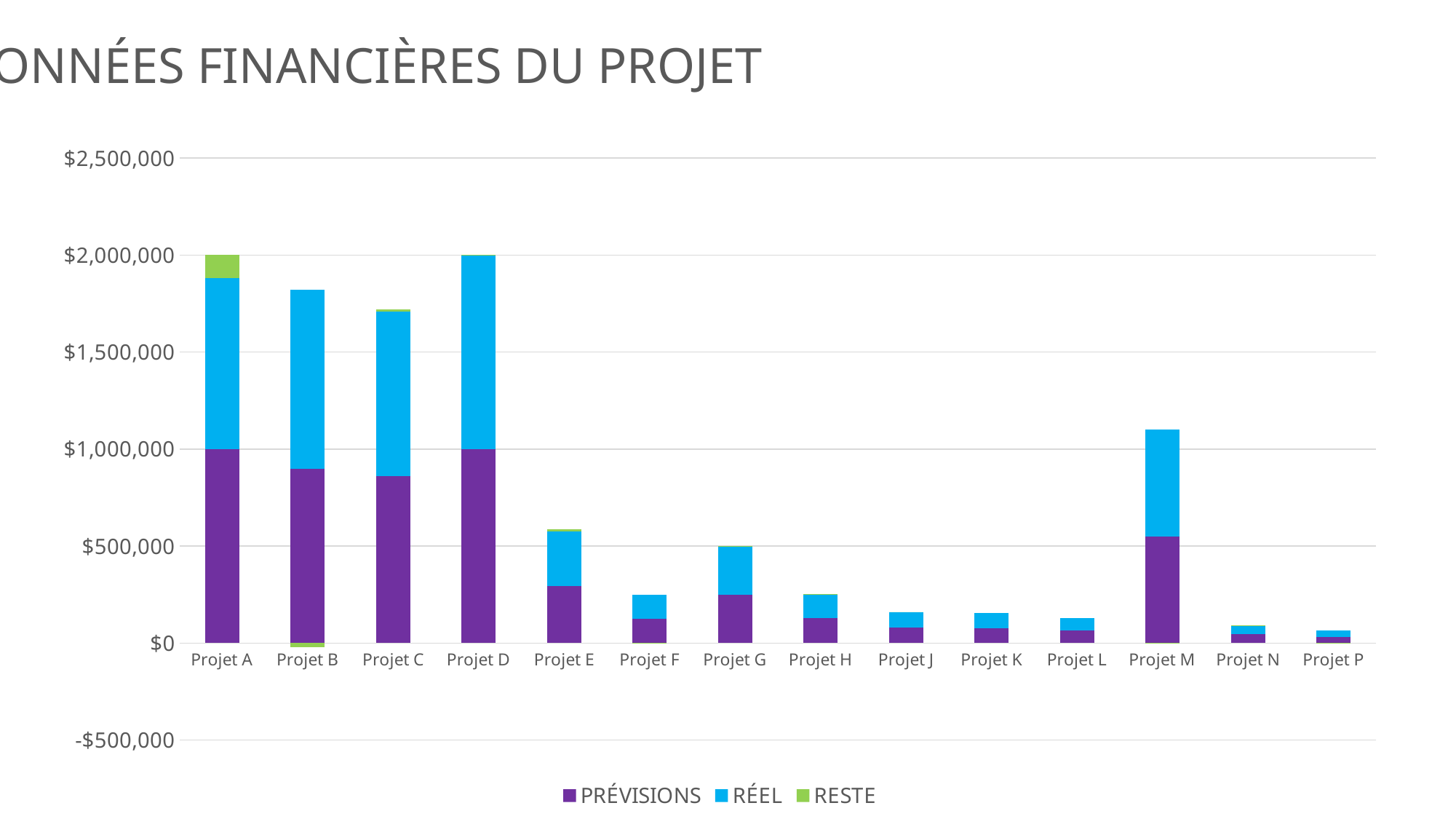
Is the PRÉVISIONS value for Projet B greater or less than $1,000,000? less Is the total stacked bar for Projet M greater or less than $1,000,000? greater Is the total stacked bar for Projet F greater or less than $500,000? less What kind of chart is shown on the slide? Stacked bar chart What colour represents the RÉEL series? Blue Which project has the lowest total stacked bar? Projet P How many series does the legend list? 3 How many projects are shown on the x axis? 14 Which has the larger total stacked bar, Projet M or Projet E? Projet M Which series are listed in the legend? PRÉVISIONS, RÉEL, RESTE Which has the larger total stacked bar, Projet B or Projet C? Projet B